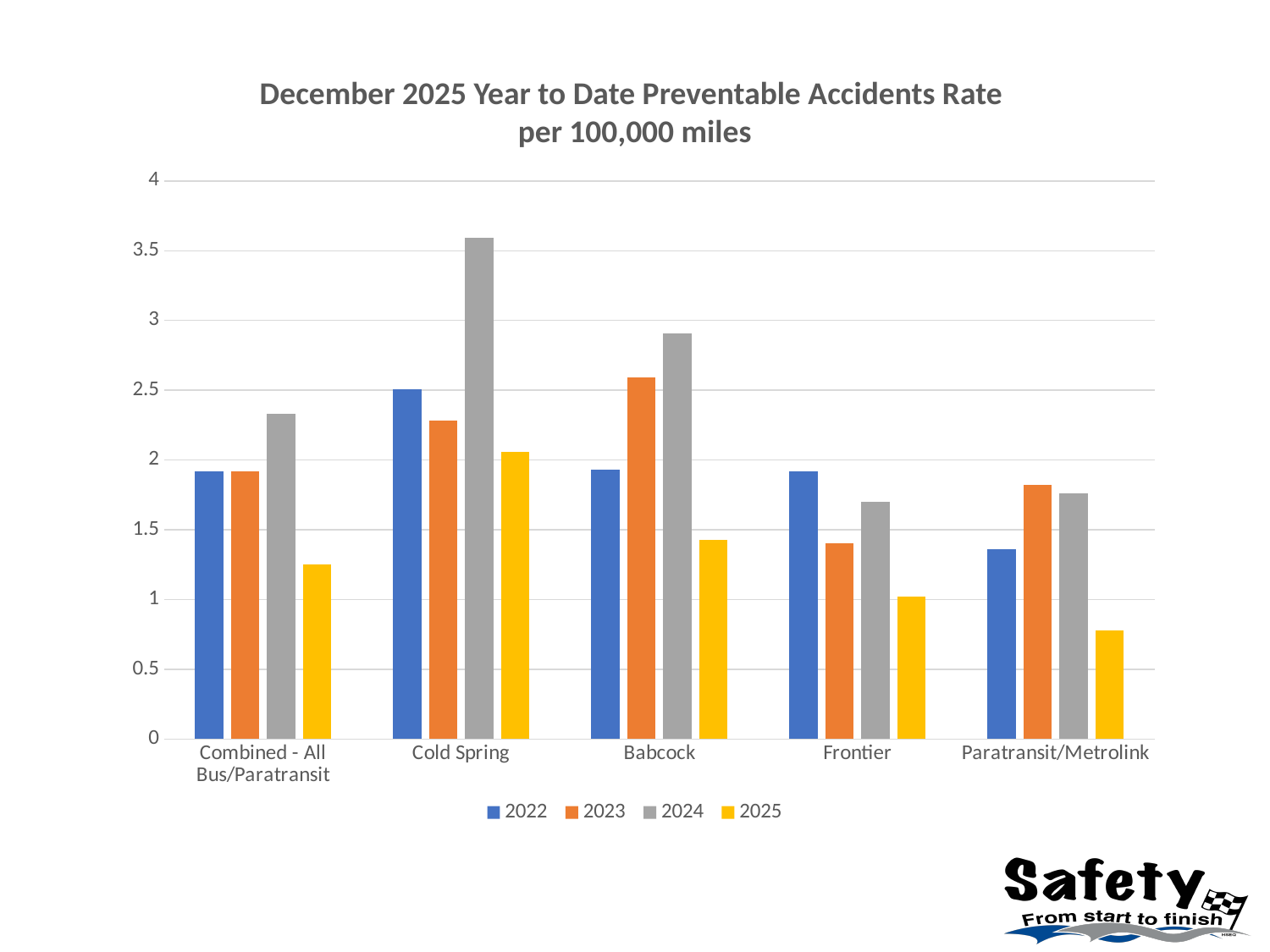
For Cold Spring, which is larger: the 2022 value or the 2023 value? 2022 What kind of chart is shown on the slide? bar chart For Babcock, which is larger: the 2022 value or the 2023 value? 2023 How many categories are shown along the x axis? 5 What is the title of the chart? December 2025 Year to Date Preventable Accidents Rate per 100,000 miles Which category has the lowest 2022 value? Paratransit/Metrolink Is the 2025 value for Combined - All Bus/Paratransit greater or less than 1.5? less Is the 2024 value for Cold Spring greater or less than 3? greater Which category has the lowest 2025 value? Paratransit/Metrolink How many series does the legend list? 4 Which category has the highest 2024 value? Cold Spring Is the 2025 value for Paratransit/Metrolink greater or less than 1? less